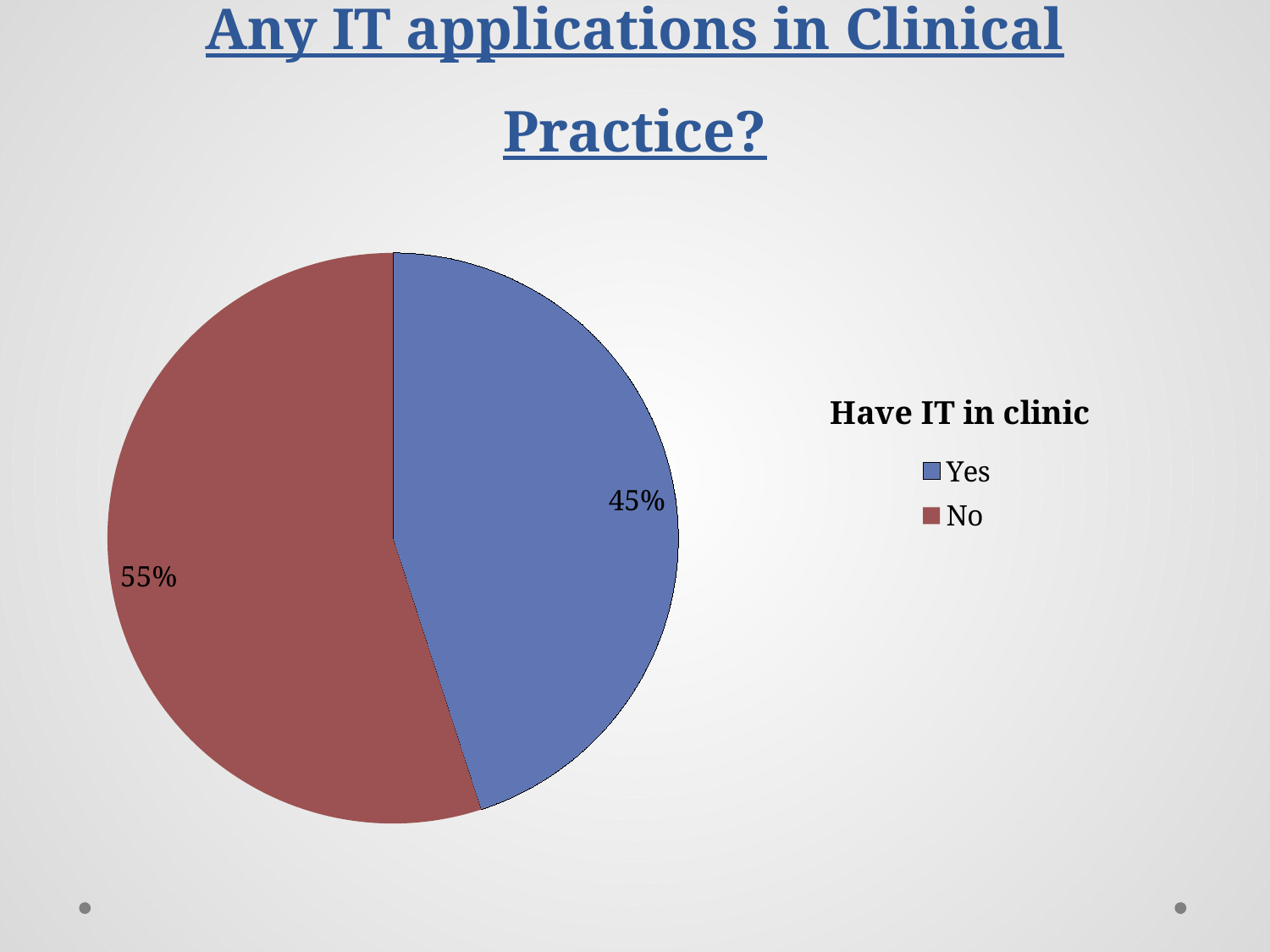
Which slice of the pie is the smallest? Yes Which is larger, the "Yes" slice or the "No" slice? No How many entries does the legend list? 2 What is the difference in percentage points between the "No" slice and the "Yes" slice? 10% What share of the pie is labelled "No"? 55% What share of the pie is labelled "Yes"? 45% What kind of chart is shown on the slide? pie chart What is the legend title of the pie chart? Have IT in clinic What colour is the "No" slice of the pie chart? red Which slice of the pie is the largest? No How many slices does the pie chart have? 2